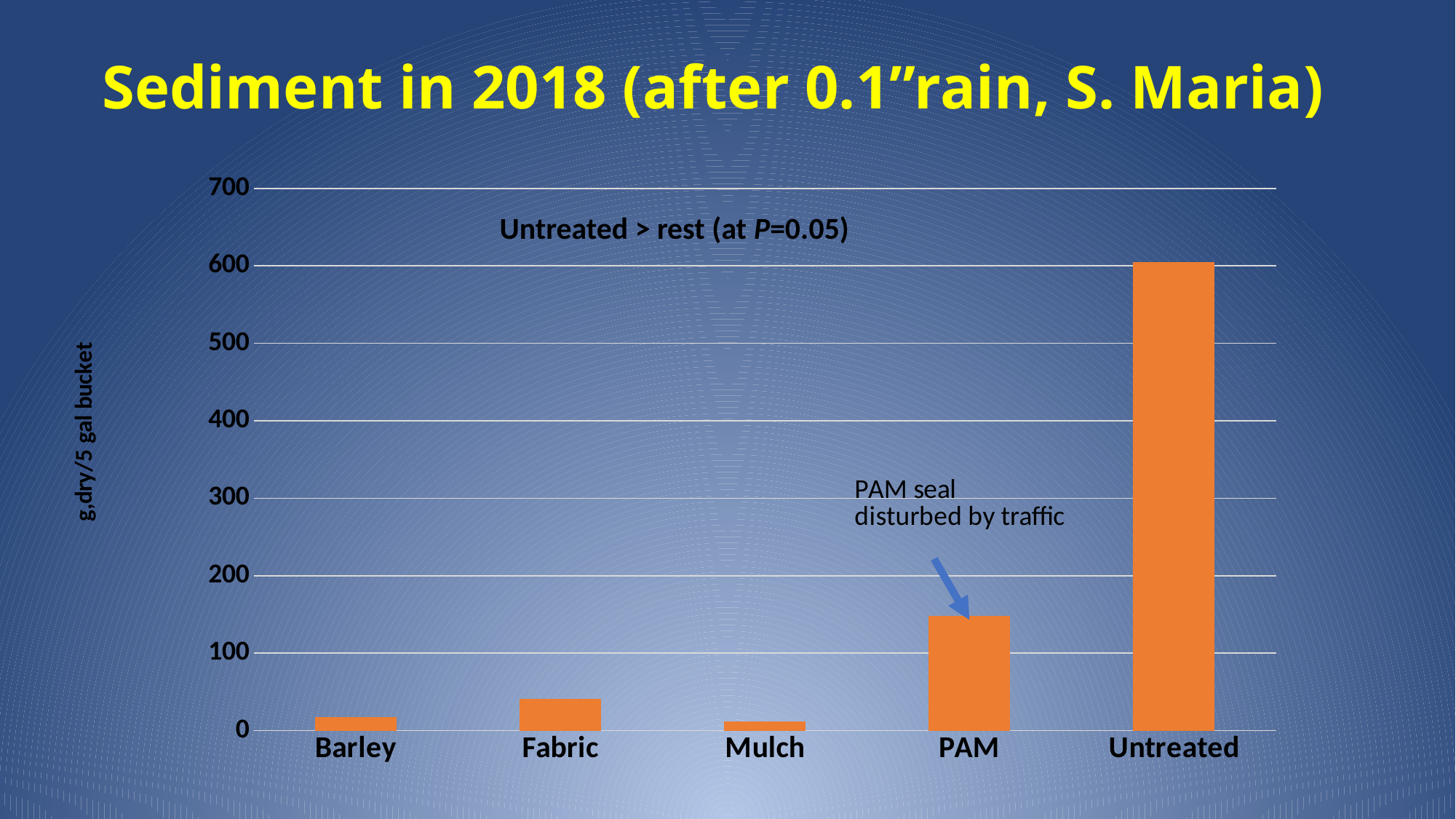
What annotation is written next to the arrow pointing at the PAM bar? PAM seal disturbed by traffic Is the value for PAM greater or less than 100? greater Which treatment has the highest sediment value? Untreated Is the value for Untreated greater or less than 500? greater Is the value for Fabric greater or less than 100? less What is the label on the y axis of the chart? g,dry/5 gal bucket Which is larger, the value for PAM or the value for Mulch? PAM Which is larger, the value for Fabric or the value for Barley? Fabric What type of chart is shown on the slide? bar chart How many treatment categories are plotted on the x axis? 5